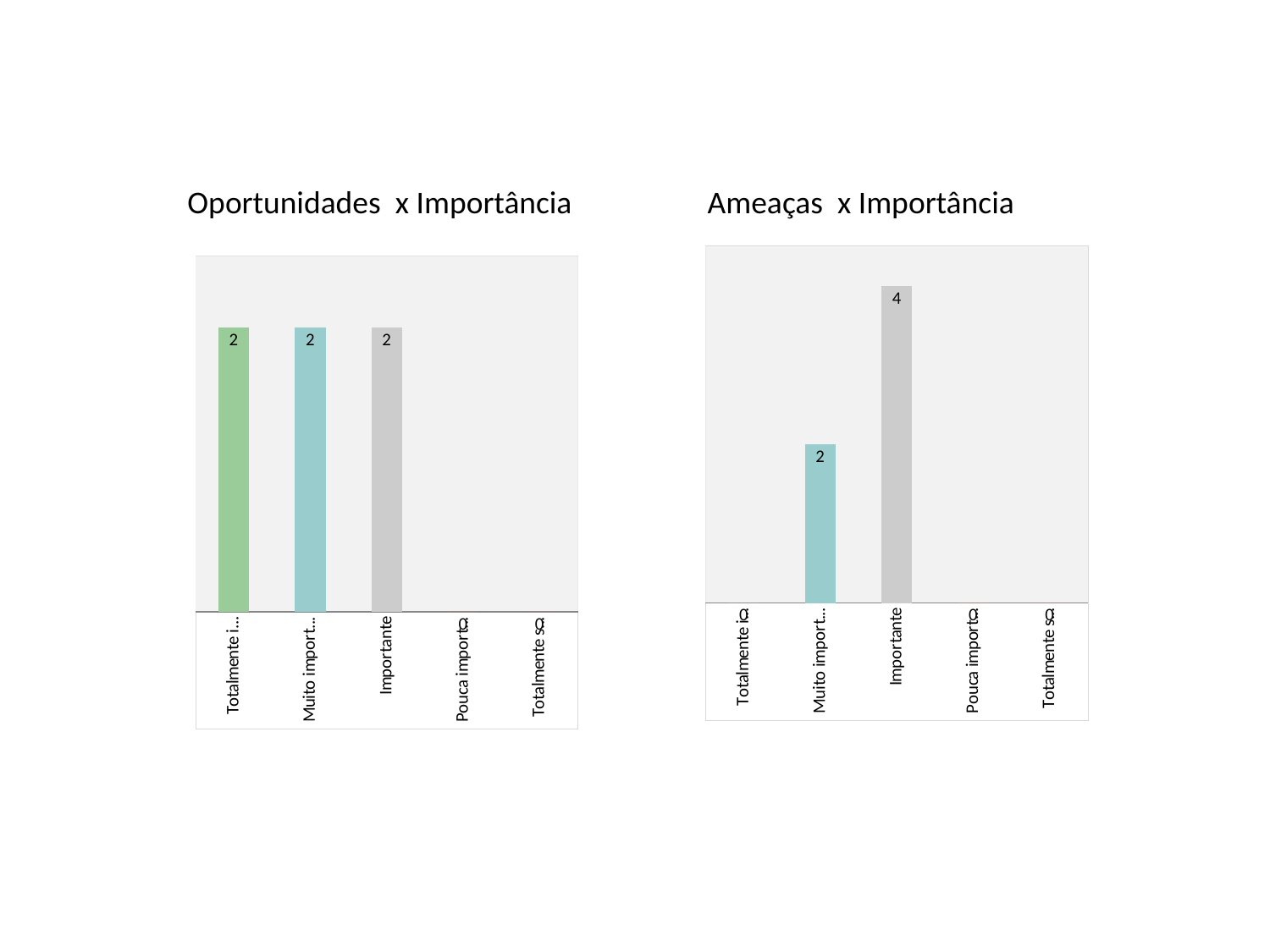
In the 'Oportunidades x Importância' chart, what colour is the bar for Importante? Grey How many categories are shown on the x axis of the 'Ameaças x Importância' chart? 5 In the 'Oportunidades x Importância' chart, how many categories have a value of 2? 3 In the 'Ameaças x Importância' chart, what is the difference between the value for Importante and the value for the 'Muito import...' category? 2 In the 'Oportunidades x Importância' chart, what is the value for Importante? 2 How many categories are shown on the x axis of the 'Oportunidades x Importância' chart? 5 In the 'Ameaças x Importância' chart, which category has the highest value? Importante In the 'Ameaças x Importância' chart, what is the value for Importante? 4 Which is larger: the value for Importante in the 'Ameaças x Importância' chart or the value for Importante in the 'Oportunidades x Importância' chart? Ameaças x Importância In the 'Ameaças x Importância' chart, which is larger: the value for Importante or the value for the 'Muito import...' category? Importante What kind of chart is the 'Oportunidades x Importância' chart? Bar chart What is the title of the chart on the right side of the slide? Ameaças x Importância